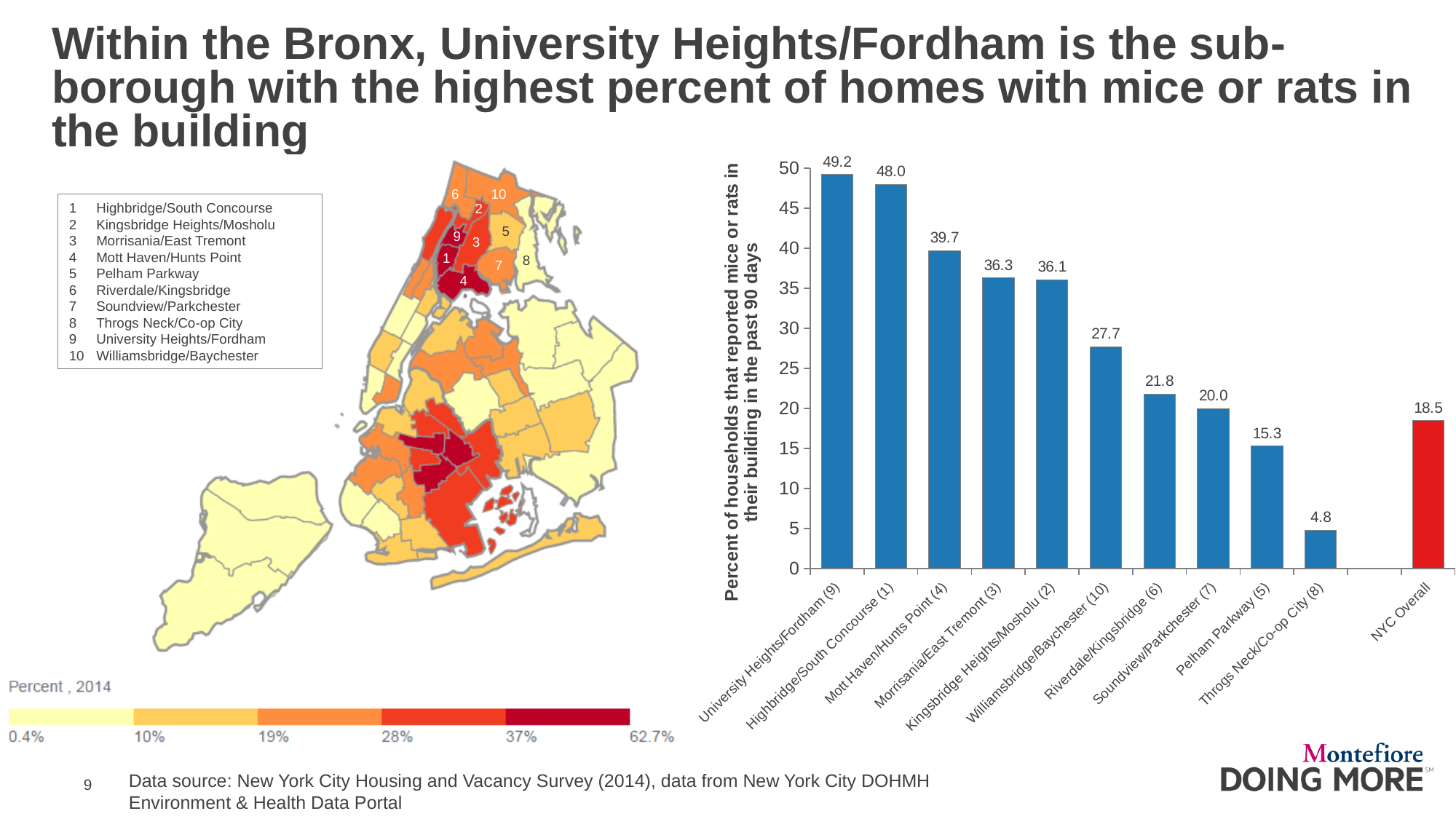
In the bar chart, what is the value for Throgs Neck/Co-op City (8)? 4.8 In the bar chart, which is larger: Pelham Parkway (5) or NYC Overall? NYC Overall In the bar chart, what colour is the NYC Overall bar? Red What kind of chart is shown on the right of the slide? Bar chart In the bar chart, what is the difference between University Heights/Fordham (9) and NYC Overall? 30.7 In the bar chart, what is the value for NYC Overall? 18.5 In the bar chart, which category has the lowest value? Throgs Neck/Co-op City (8) In the bar chart, what is the difference between University Heights/Fordham (9) and Highbridge/South Concourse (1)? 1.2 In the bar chart, what is the value for University Heights/Fordham (9)? 49.2 How many bars are shown in the bar chart? 11 In the bar chart, which category has the highest value? University Heights/Fordham (9) In the bar chart, what is the value for Williamsbridge/Baychester (10)? 27.7